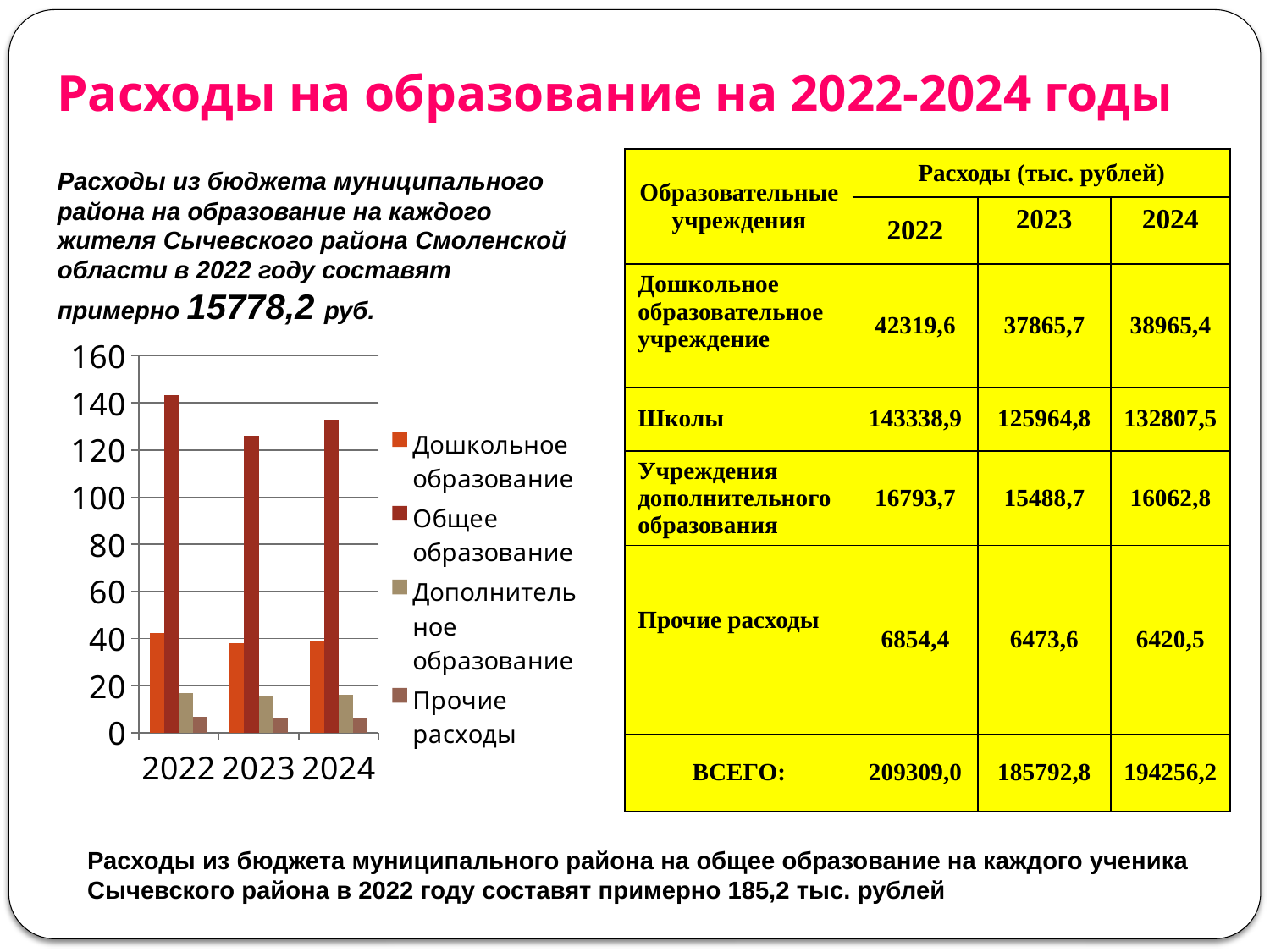
In the chart, which year has the highest value for Общее образование? 2022 How many years are shown on the x axis of the chart? 3 In the chart, does the value for Общее образование rise or fall from 2022 to 2023? fall In the chart, is the value for Общее образование in 2024 greater or less than 140? less Which series in the chart is shown in dark red? Общее образование In the chart, is the value for Дошкольное образование in 2022 greater or less than 60? less What kind of chart is shown on the slide? bar chart In the chart, is the value for Дополнительное образование in 2022 greater or less than 20? less In the chart, which is larger in 2022: Дошкольное образование or Общее образование? Общее образование How many series does the chart legend list? 4 In the chart, which year has the lowest value for Общее образование? 2023